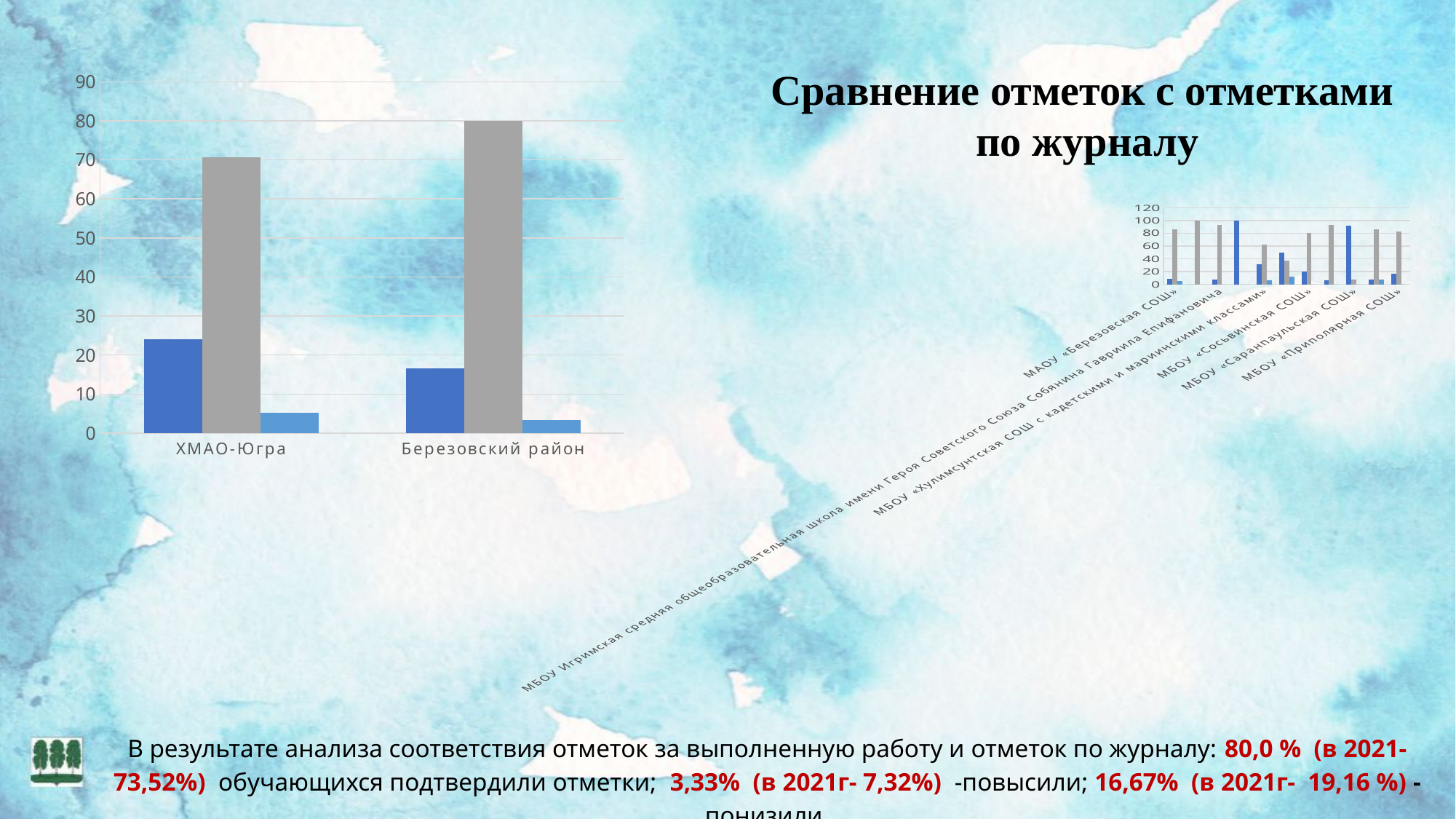
In the left chart, which category has the taller gray bar? Березовский район What kind of chart is the chart on the left side of the slide? bar chart What is the highest value shown on the y axis of the small chart on the right? 120 In the left chart, is the dark blue bar for Березовский район greater or less than 20? less How many categories are shown on the x axis of the left chart? 2 In the left chart, is the gray bar for ХМАО-Югра greater or less than 60? greater In the left chart, which category has the taller dark blue bar, ХМАО-Югра or Березовский район? ХМАО-Югра What kind of chart is the small chart on the right side of the slide? bar chart In the left chart, which category has the shorter light blue bar? Березовский район In the left chart, is the light blue bar for Березовский район greater or less than 10? less